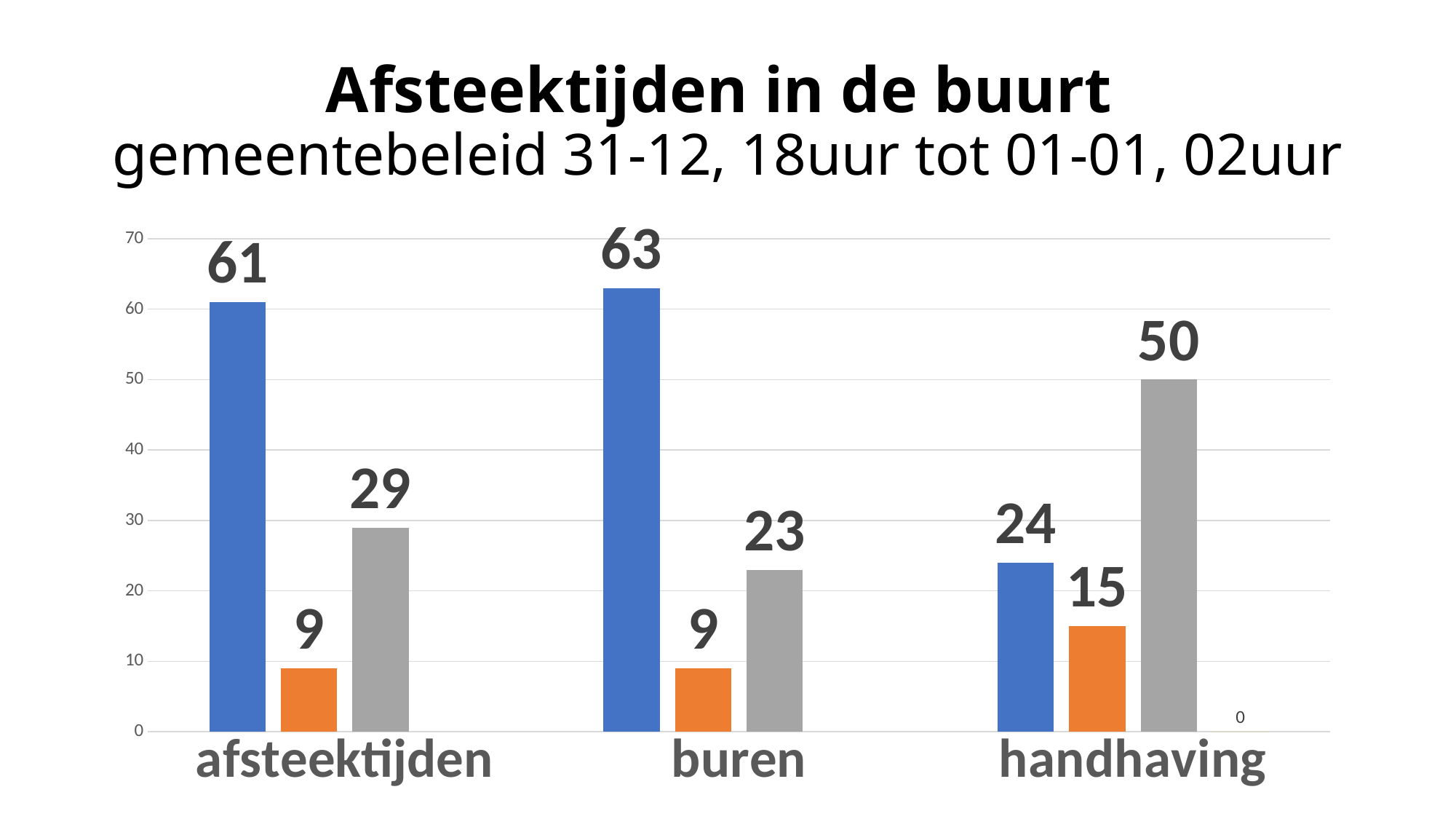
What is the value of the orange bar for buren? 9 What is the value of the grey bar for afsteektijden? 29 What is the value of the blue bar for afsteektijden? 61 How many categories are shown on the x axis? 3 Which category has the highest blue bar? buren What is the value of the grey bar for handhaving? 50 What is the difference between the blue bar for buren and the blue bar for afsteektijden? 2 Which category has the lowest blue bar? handhaving What is the difference between the grey bar for handhaving and the grey bar for buren? 27 Which is larger for handhaving, the grey bar or the blue bar? the grey bar What kind of chart is shown on the slide? bar chart What is the title of the chart? Afsteektijden in de buurt